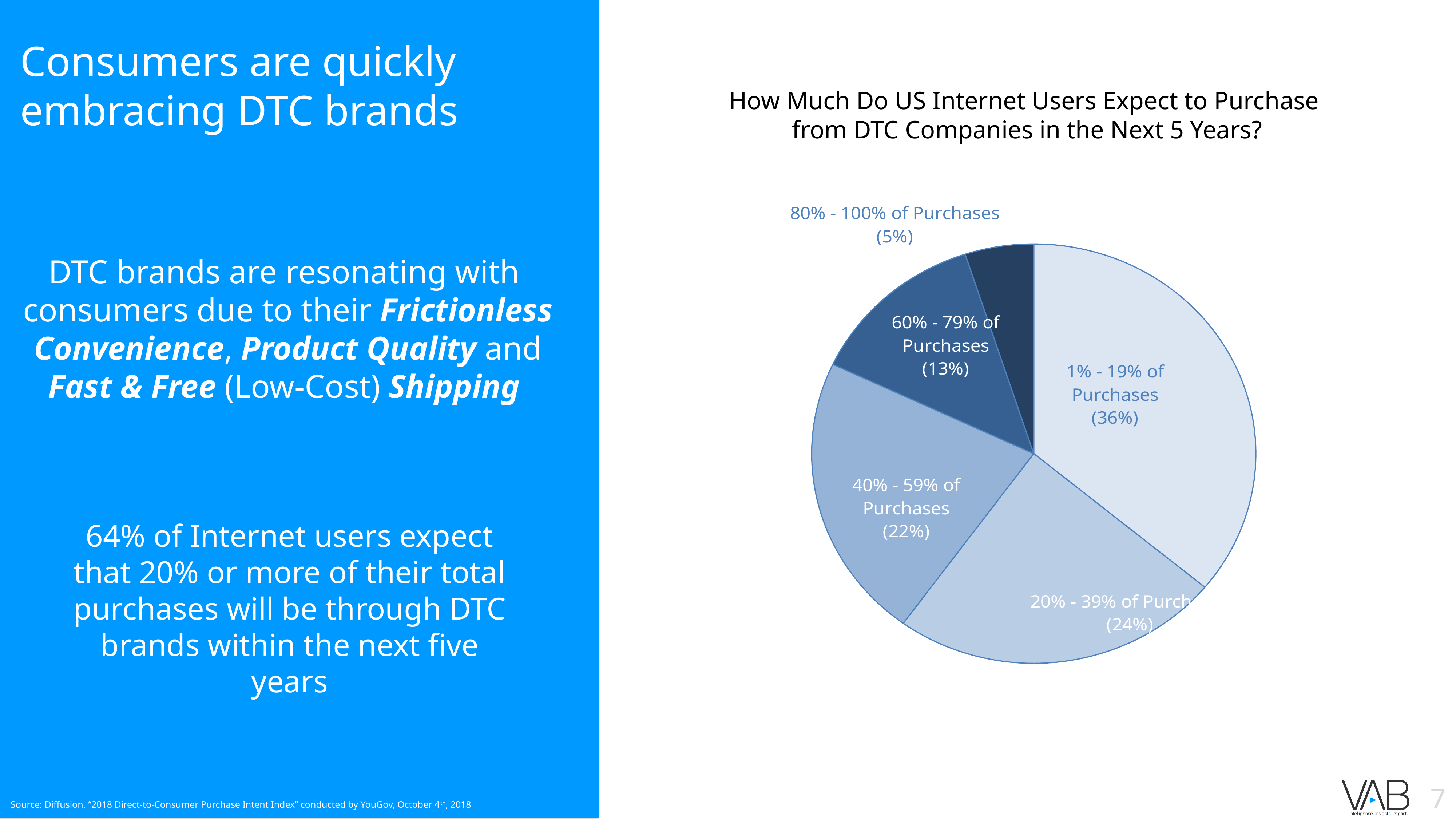
What share of US internet users expect 20% - 39% of their purchases to come from DTC companies? 24% Which purchase range has the smallest slice of the pie? 80% - 100% of Purchases What share of US internet users expect 1% - 19% of their purchases to come from DTC companies in the next 5 years? 36% Which is larger: the share for 20% - 39% of Purchases or the share for 40% - 59% of Purchases? 20% - 39% of Purchases Which purchase range has the largest slice of the pie? 1% - 19% of Purchases What share of US internet users expect 80% - 100% of their purchases to come from DTC companies? 5% How many slices does the pie chart have? 5 What share of US internet users expect 40% - 59% of their purchases to come from DTC companies? 22% What kind of chart is shown on the slide? Pie chart What is the difference between the share for 1% - 19% of Purchases and the share for 60% - 79% of Purchases? 23 percentage points What share of US internet users expect 60% - 79% of their purchases to come from DTC companies? 13% What is the title of the pie chart? How Much Do US Internet Users Expect to Purchase from DTC Companies in the Next 5 Years?